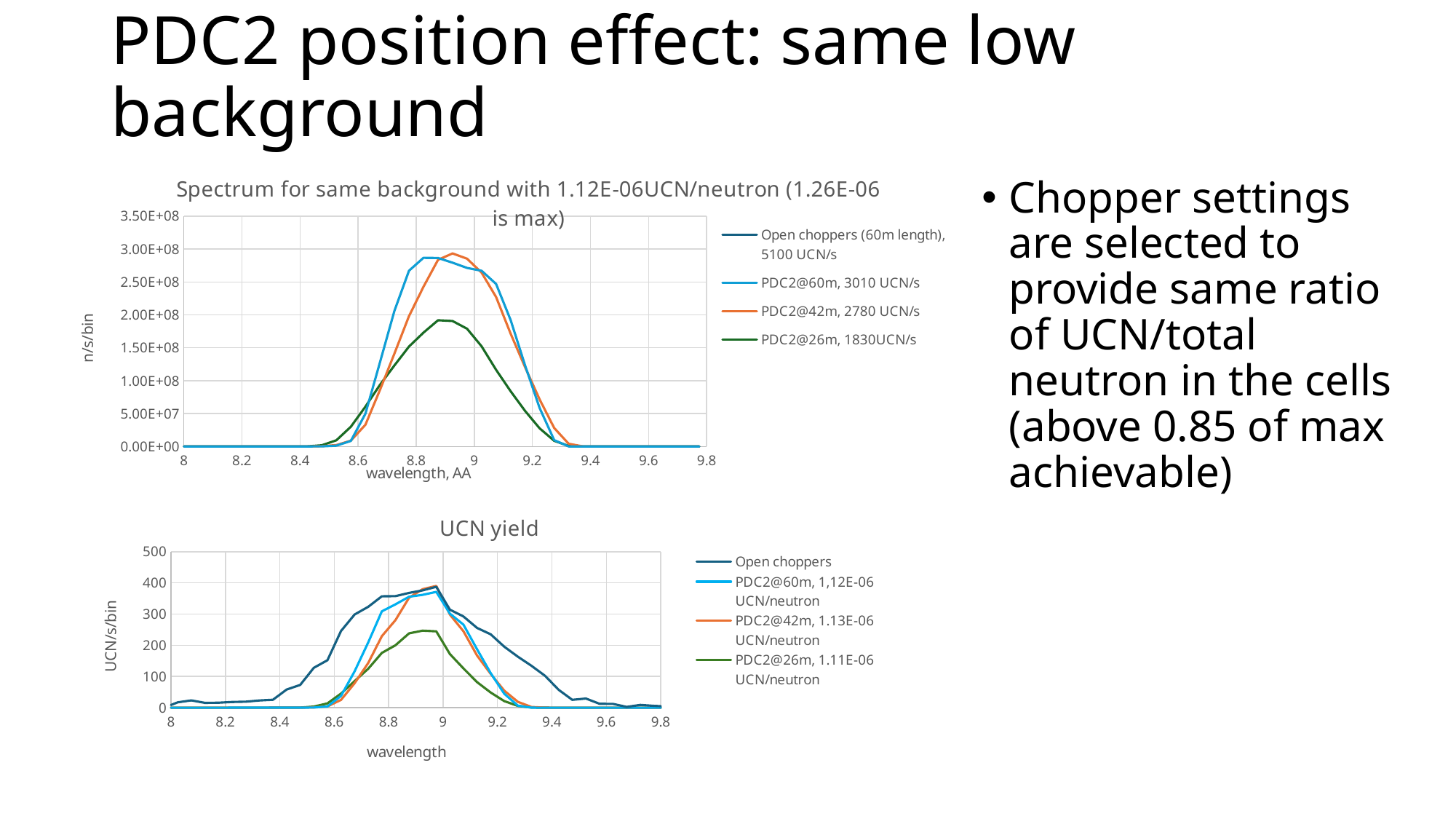
What kind of chart is the top chart titled 'Spectrum for same background with 1.12E-06UCN/neutron (1.26E-06 is max)'? line chart In the bottom 'UCN yield' chart, is the peak value of the Open choppers series greater or less than 300? greater In the bottom 'UCN yield' chart, which series reaches a higher peak: Open choppers or PDC2@26m? Open choppers What kind of chart is the bottom chart titled 'UCN yield'? line chart How many series does the legend of the bottom 'UCN yield' chart list? 4 In the top 'Spectrum for same background' chart, is the peak value of the PDC2@26m, 1830UCN/s series greater or less than 2.00E+08? less In the top 'Spectrum for same background' chart, is the peak value of the PDC2@42m, 2780 UCN/s series greater or less than 2.50E+08? greater What is the y-axis label of the bottom 'UCN yield' chart? UCN/s/bin What is the x-axis label of the top 'Spectrum for same background' chart? wavelength, AA How many series does the legend of the top 'Spectrum for same background' chart list? 4 In the top 'Spectrum for same background' chart, which series has the lower peak: PDC2@26m, 1830UCN/s or PDC2@42m, 2780 UCN/s? PDC2@26m, 1830UCN/s